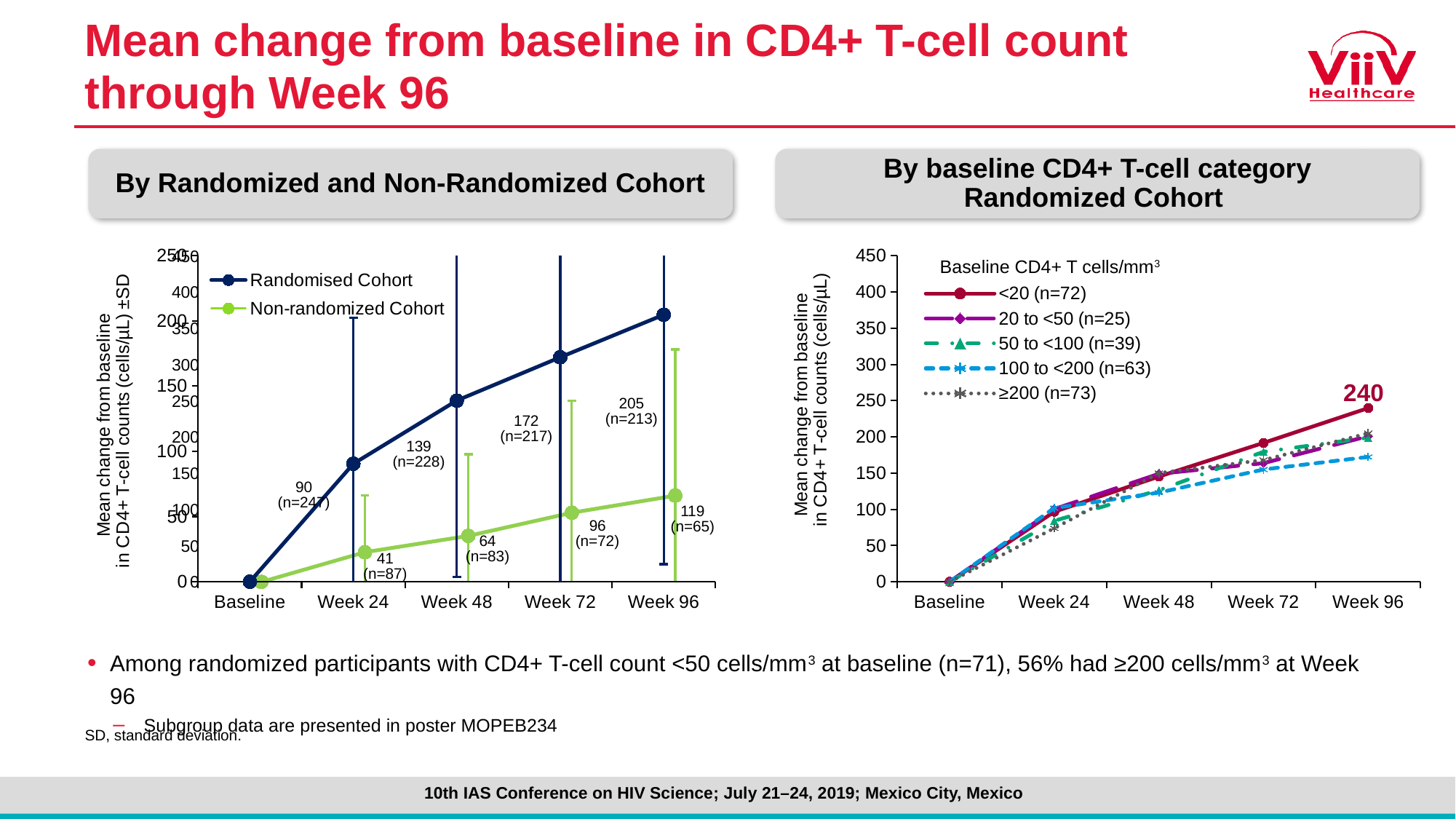
In the chart 'By Randomized and Non-Randomized Cohort', which cohort has the larger mean change from baseline at Week 96? Randomised Cohort In the chart 'By Randomized and Non-Randomized Cohort', what is the mean change from baseline for the Randomised Cohort at Week 48? 139 In the chart 'By Randomized and Non-Randomized Cohort', what is the difference between the Randomised Cohort and Non-randomized Cohort values at Week 72? 76 In the chart 'By baseline CD4+ T-cell category Randomized Cohort', how many baseline CD4+ categories does the legend list? 5 In the chart 'By baseline CD4+ T-cell category Randomized Cohort', is the value for the 100 to <200 (n=63) group at Week 96 greater or less than 200? less In the chart 'By baseline CD4+ T-cell category Randomized Cohort', what is the mean change from baseline for the <20 (n=72) group at Week 96? 240 In the chart 'By Randomized and Non-Randomized Cohort', what is the mean change from baseline for the Randomised Cohort at Week 96? 205 What kind of chart is 'By baseline CD4+ T-cell category Randomized Cohort'? line chart In the chart 'By Randomized and Non-Randomized Cohort', what is the n for the Non-randomized Cohort at Week 96? n=65 In the chart 'By Randomized and Non-Randomized Cohort', how many series does the legend list? 2 In the chart 'By Randomized and Non-Randomized Cohort', what is the mean change from baseline for the Non-randomized Cohort at Week 24? 41 In the chart 'By Randomized and Non-Randomized Cohort', does the Non-randomized Cohort value rise or fall from Baseline to Week 96? rise